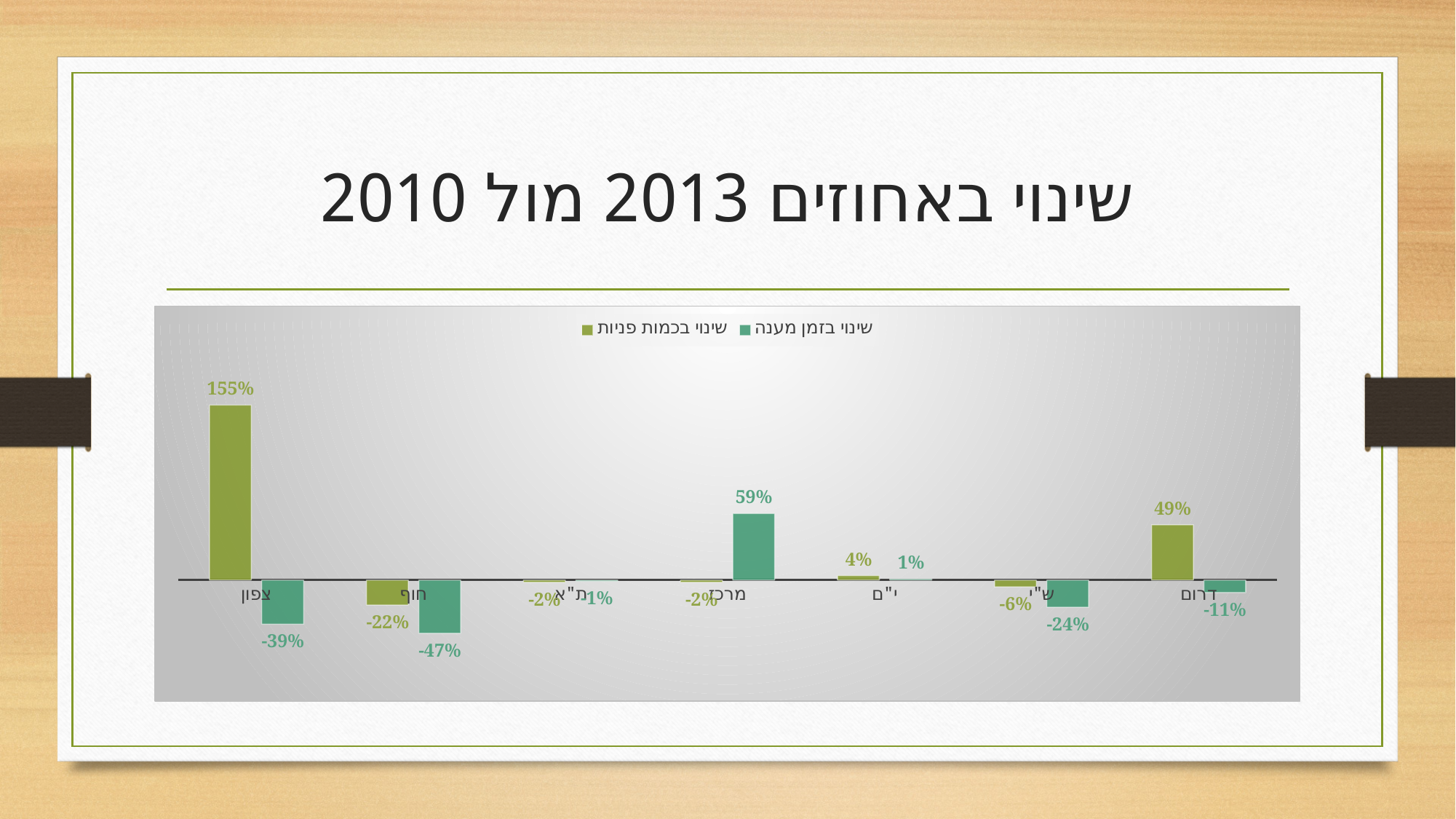
What is the value of שינוי בזמן מענה for מרכז? 59% What is the difference between the שינוי בכמות פניות values for צפון and דרום? 106% What is the value of שינוי בכמות פניות for צפון? 155% How many series does the legend list? 2 Which category has the lowest value for שינוי בזמן מענה? חוף What is the value of שינוי בזמן מענה for חוף? -47% What is the value of שינוי בזמן מענה for ש"י? -24% Which is larger, the שינוי בזמן מענה value for מרכז or for י"ם? מרכז What kind of chart is shown on the slide? Bar chart Which category has the highest value for שינוי בכמות פניות? צפון What is the value of שינוי בכמות פניות for דרום? 49% How many categories are shown on the x axis? 7